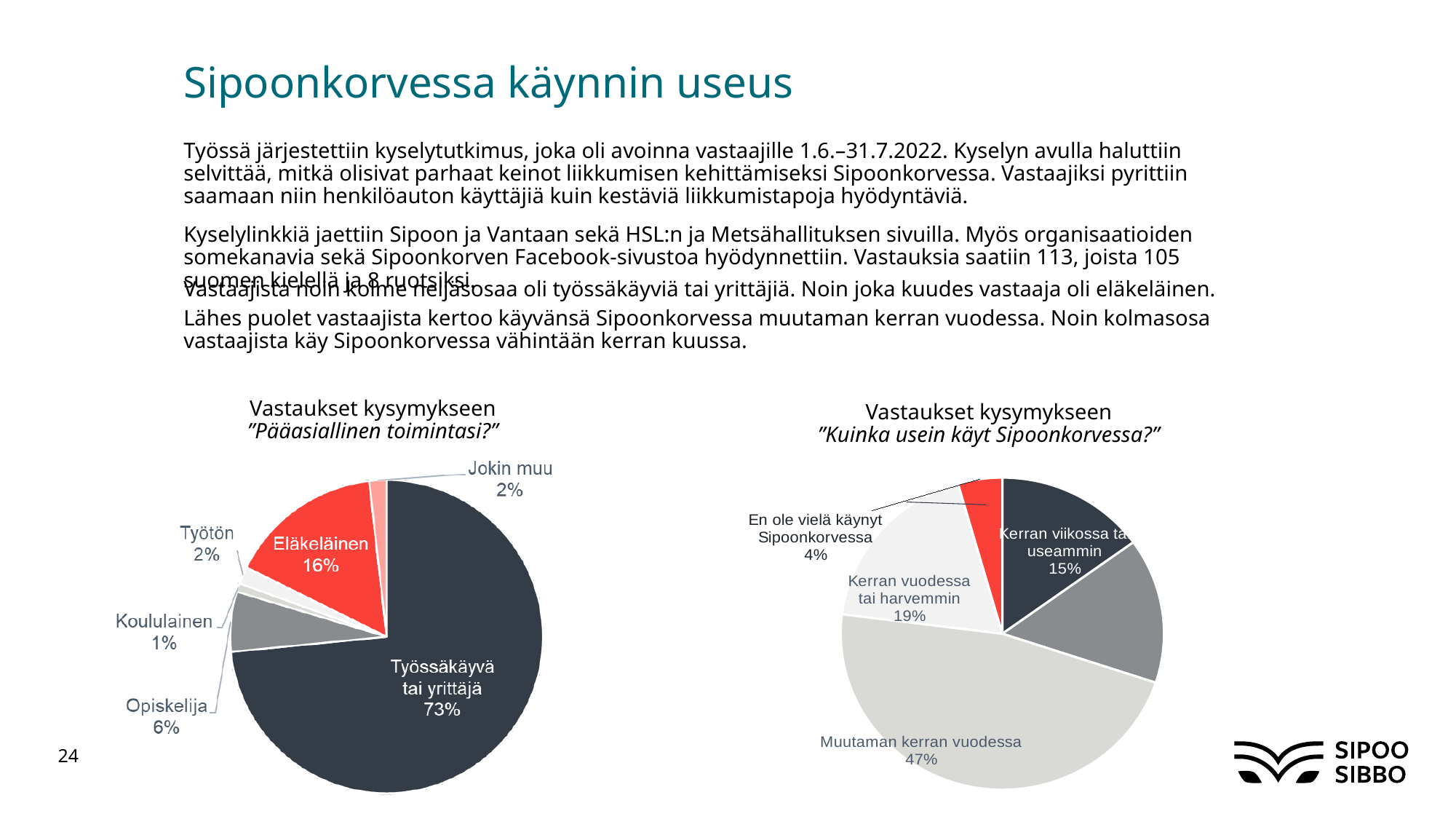
In the left chart "Pääasiallinen toimintasi?", what share of respondents are Työssäkäyvä tai yrittäjä? 73% In the right chart "Kuinka usein käyt Sipoonkorvessa?", what share of respondents answered Muutaman kerran vuodessa? 47% In the right chart "Kuinka usein käyt Sipoonkorvessa?", which category has the largest share? Muutaman kerran vuodessa In the right chart "Kuinka usein käyt Sipoonkorvessa?", what share of respondents answered En ole vielä käynyt Sipoonkorvessa? 4% In the left chart "Pääasiallinen toimintasi?", which category has the smallest share? Koululainen In the right chart "Kuinka usein käyt Sipoonkorvessa?", what share of respondents answered Kerran vuodessa tai harvemmin? 19% In the left chart "Pääasiallinen toimintasi?", how many slices does the pie have? 6 In the left chart "Pääasiallinen toimintasi?", what share of respondents are Eläkeläinen? 16% In the left chart "Pääasiallinen toimintasi?", what is the difference in percentage points between Eläkeläinen and Opiskelija? 10 In the left chart "Pääasiallinen toimintasi?", which category has the largest share? Työssäkäyvä tai yrittäjä In the right chart "Kuinka usein käyt Sipoonkorvessa?", which is larger: Kerran viikossa tai useammin or Kerran vuodessa tai harvemmin? Kerran vuodessa tai harvemmin What kind of chart is the left chart, "Pääasiallinen toimintasi?"? pie chart